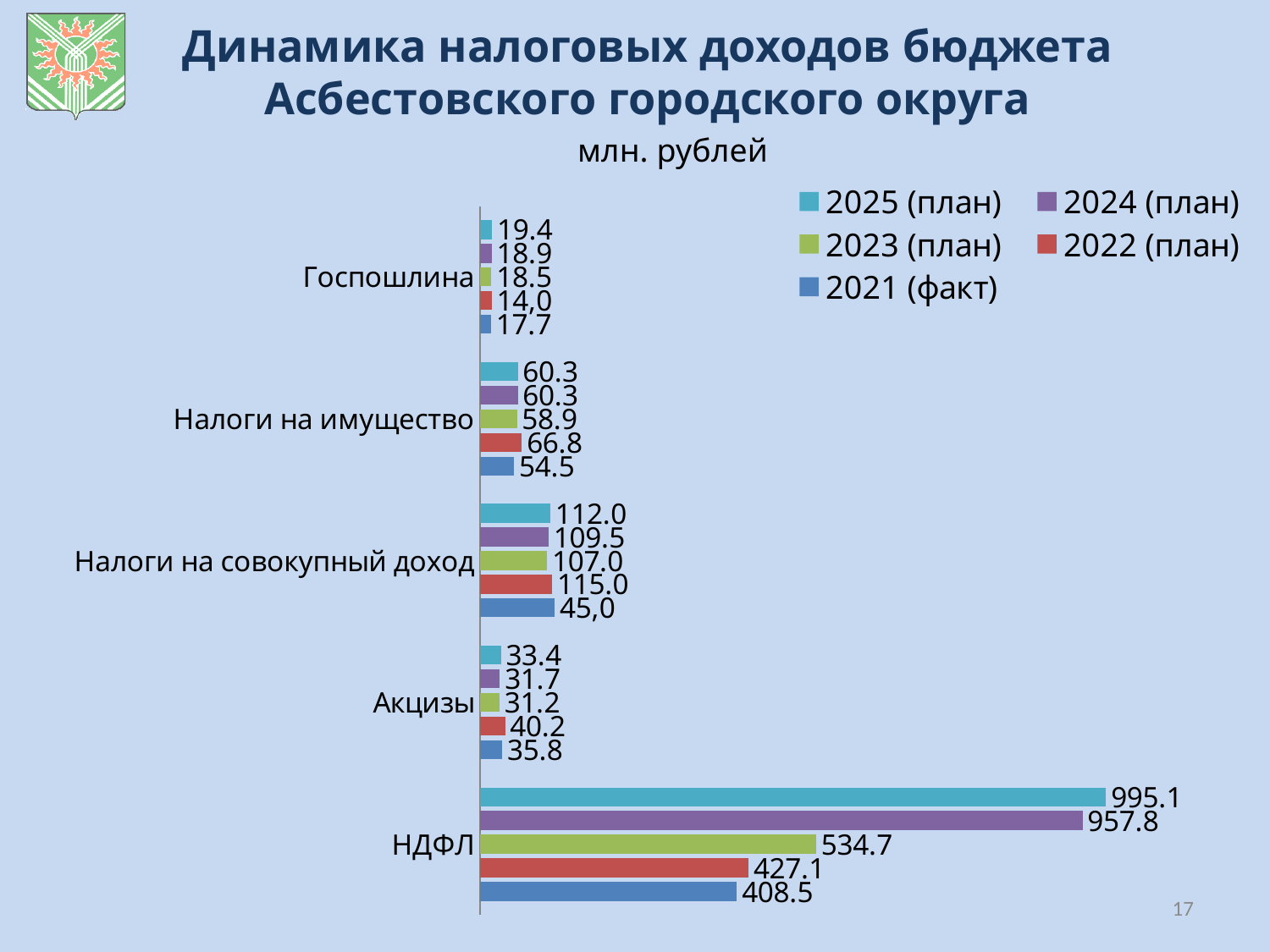
What unit is stated below the chart title? млн. рублей What is the value for НДФЛ in the 2025 (план) series? 995.1 What kind of chart is shown on the slide? Bar chart How many categories are shown on the chart? 5 How many series does the legend list? 5 Which category has the highest value in the 2024 (план) series? НДФЛ What is the value for Акцизы in the 2022 (план) series? 40.2 Which category has the lowest value in the 2021 (факт) series? Госпошлина What is the value for Госпошлина in the 2023 (план) series? 18.5 What is the difference between the 2025 (план) and 2021 (факт) values for НДФЛ? 586.6 What is the value for Налоги на совокупный доход in the 2021 (факт) series? 45,0 Which is larger for Налоги на имущество: the 2022 (план) value or the 2021 (факт) value? 2022 (план)